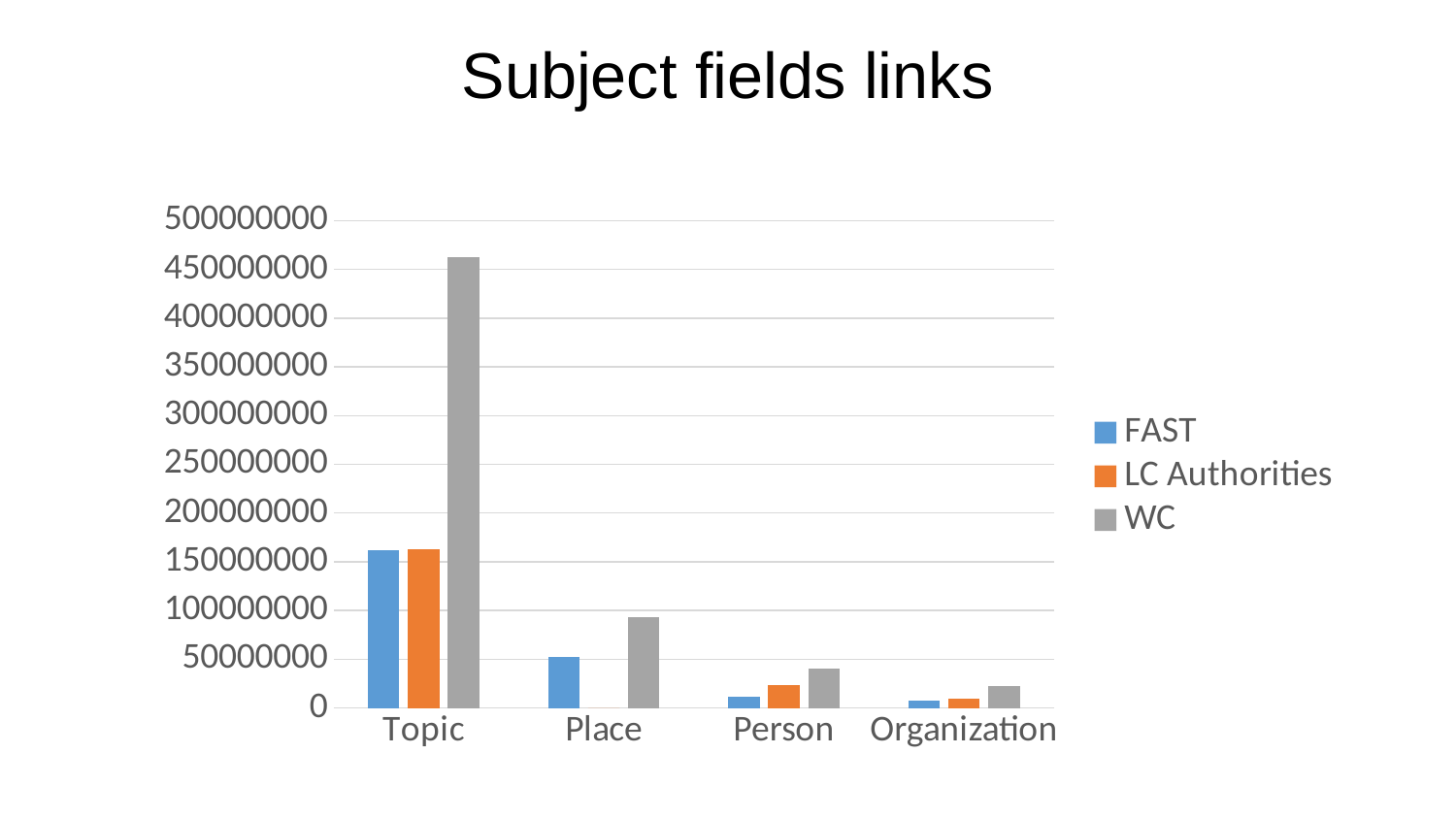
Is the WC value for Place greater or less than 100000000? less Which category has the highest WC value? Topic How many series does the legend list? 3 How many categories are shown on the x axis? 4 Which category has the lowest WC value? Organization What is the title of the chart? Subject fields links For Place, which is larger: the FAST value or the WC value? WC Is the WC value for Topic greater or less than 400000000? greater What kind of chart is shown on the slide? bar chart Is the FAST value for Topic greater or less than 200000000? less Do the WC values rise or fall from Topic to Organization along the x axis? fall